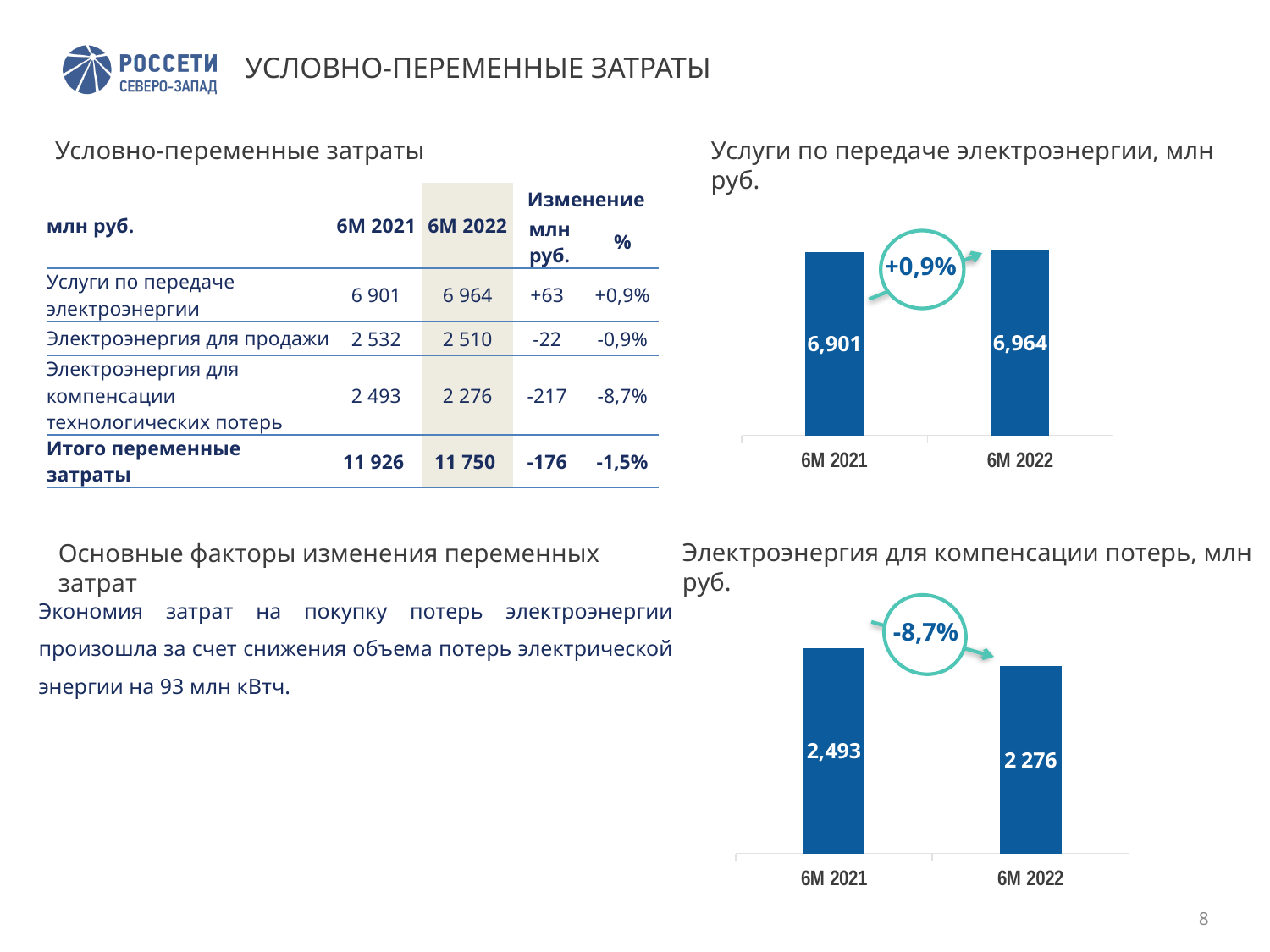
In the chart titled "Электроэнергия для компенсации потерь, млн руб.", what is the value for 6M 2021? 2,493 What kind of chart is the chart titled "Электроэнергия для компенсации потерь, млн руб."? bar chart In the chart titled "Электроэнергия для компенсации потерь, млн руб.", which period has the lower value? 6M 2022 In the chart titled "Услуги по передаче электроэнергии, млн руб.", what is the value for 6M 2022? 6,964 In the chart titled "Электроэнергия для компенсации потерь, млн руб.", is the value for 6M 2021 larger or smaller than the value for 6M 2022? larger In the chart titled "Услуги по передаче электроэнергии, млн руб.", what is the difference between the 6M 2022 and 6M 2021 values? 63 In the chart titled "Услуги по передаче электроэнергии, млн руб.", which period has the higher value? 6M 2022 How many bars are shown in the chart titled "Услуги по передаче электроэнергии, млн руб."? 2 In the chart titled "Услуги по передаче электроэнергии, млн руб.", what is the value for 6M 2021? 6,901 In the chart titled "Электроэнергия для компенсации потерь, млн руб.", what is the value for 6M 2022? 2 276 In the chart titled "Электроэнергия для компенсации потерь, млн руб.", what is the difference between the 6M 2021 and 6M 2022 values? 217 What percentage change is shown in the circle annotation on the chart titled "Электроэнергия для компенсации потерь, млн руб."? -8,7%